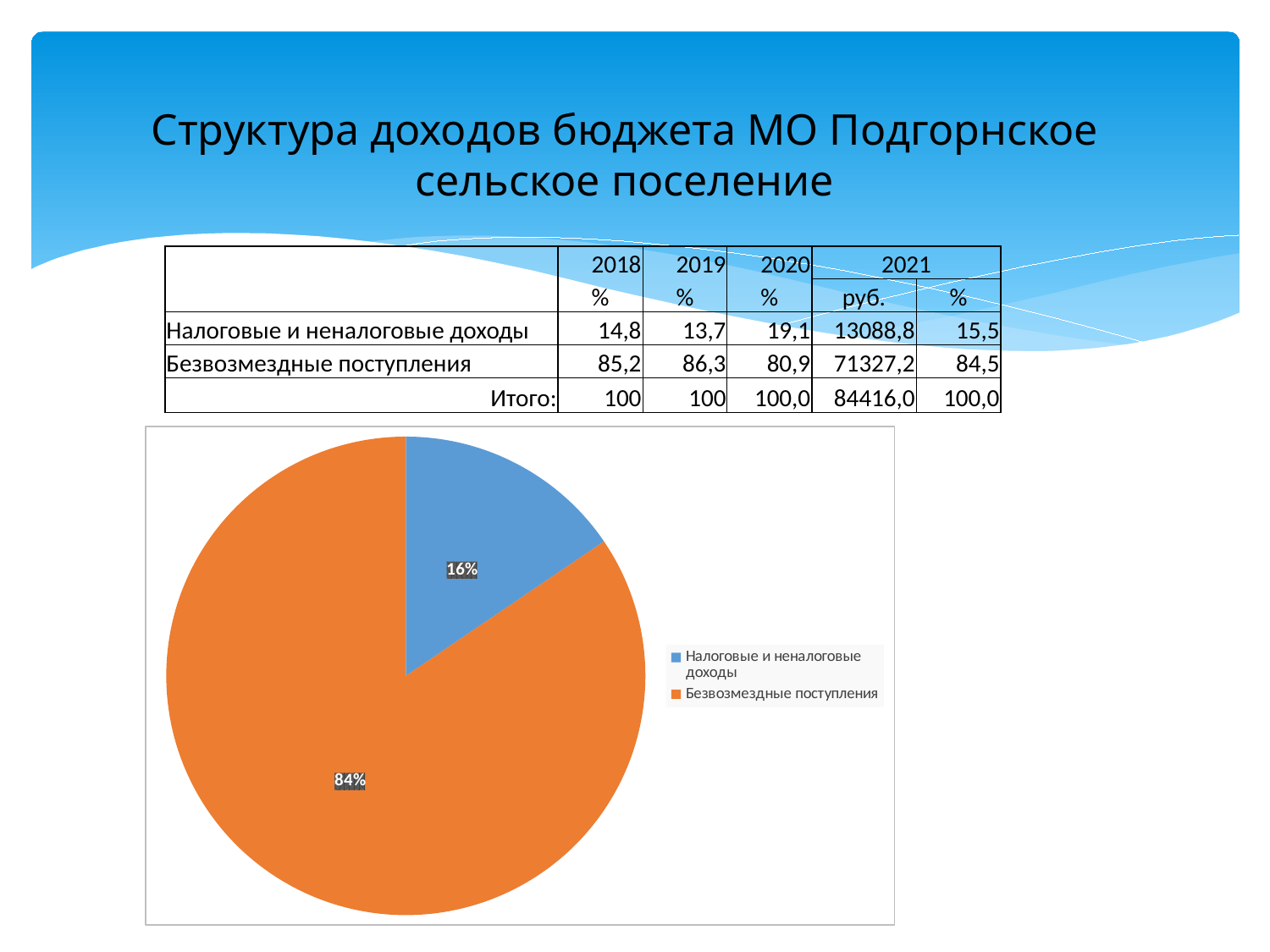
What is the total of the two slice percentages shown on the pie chart? 100% How many entries does the legend of the pie chart list? 2 What is the difference in percentage points between the "Безвозмездные поступления" slice and the "Налоговые и неналоговые доходы" slice? 68 What kind of chart is shown on the slide? pie chart Which is larger in the pie chart: "Налоговые и неналоговые доходы" or "Безвозмездные поступления"? Безвозмездные поступления How many slices does the pie chart have? 2 What colour is the "Налоговые и неналоговые доходы" slice in the pie chart? blue What colour is the "Безвозмездные поступления" slice in the pie chart? orange What share of the pie does "Безвозмездные поступления" represent? 84% What share of the pie does "Налоговые и неналоговые доходы" represent? 16% Which slice of the pie chart is the smallest? Налоговые и неналоговые доходы Which slice of the pie chart is the largest? Безвозмездные поступления